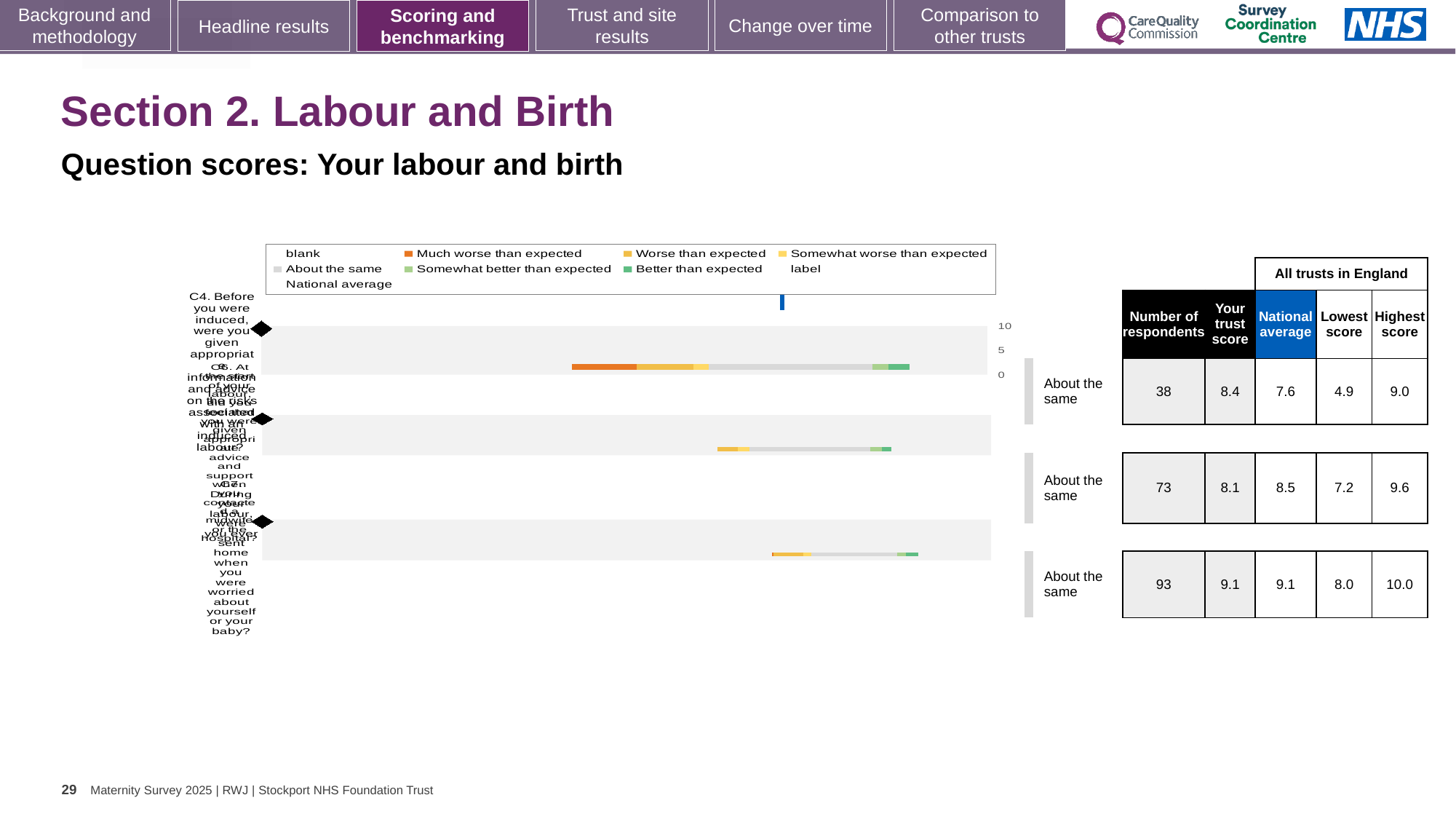
In the table, what is the number of respondents for the third (bottom) question? 93 For the first (top) question, C4, what is the difference between the trust score and the national average? 0.8 For the first (top) question, C4, which is larger: the trust score or the national average? trust score In the table, what is the national average for the first (top) question, C4? 7.6 In the table, which row has the lowest 'Lowest score' value? the first (top) row, C4, with 4.9 In the table, what is the number of respondents for the first (top) question, C4? 38 In the legend, which colour represents 'Much worse than expected'? orange How many question bars are plotted in the chart? 3 What benchmark label is shown next to each of the three bars? About the same What kind of chart is shown on the slide? bar chart In the table, what is the trust score for the first (top) question, C4? 8.4 In the table, what is the highest score for the third (bottom) question? 10.0